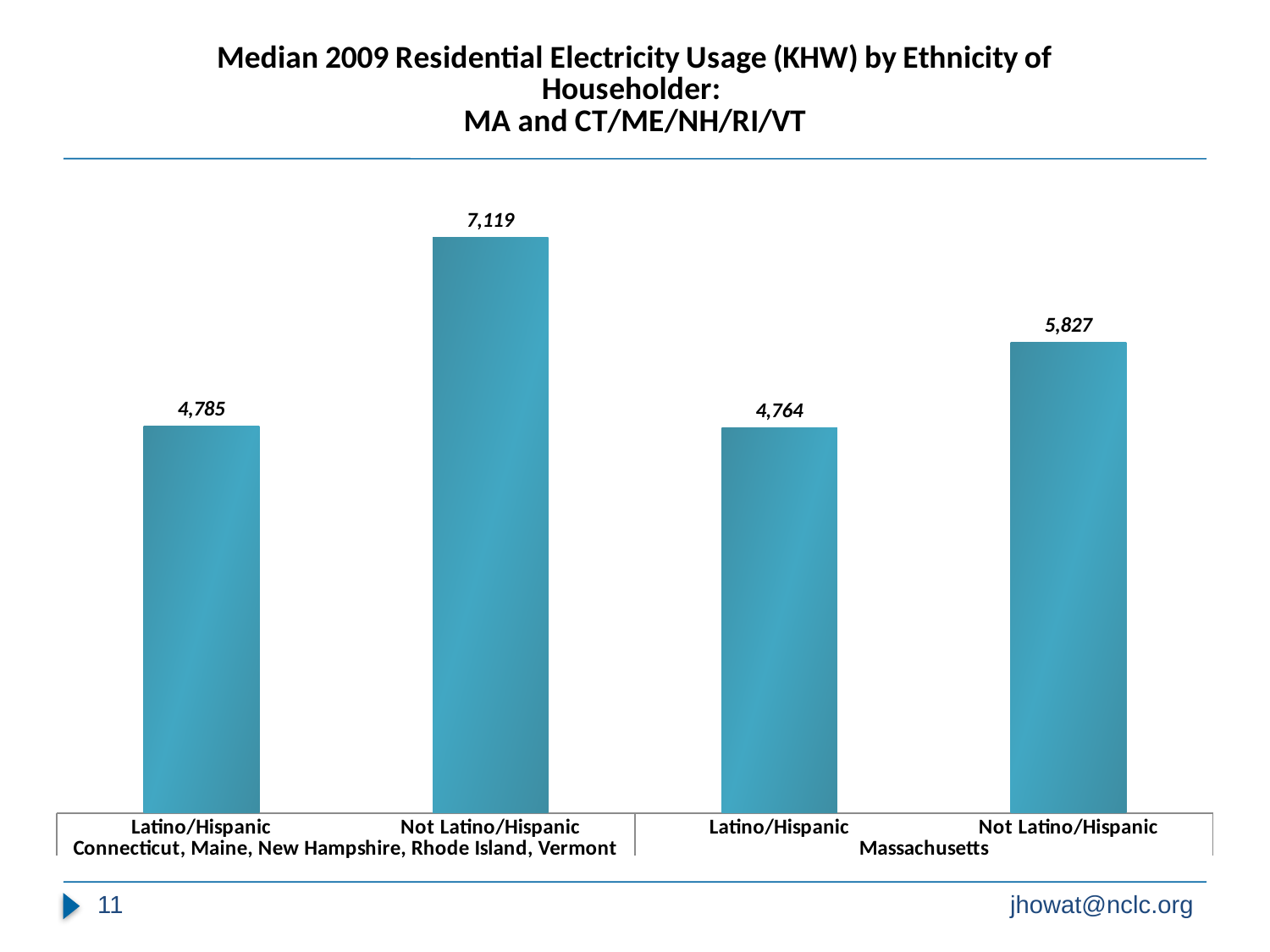
What kind of chart is shown on the slide? Bar chart What is the difference between the Not Latino/Hispanic and Latino/Hispanic values in Massachusetts? 1,063 Which bar has the highest value on the chart? Not Latino/Hispanic, Connecticut, Maine, New Hampshire, Rhode Island, Vermont What is the median 2009 residential electricity usage for Not Latino/Hispanic householders in Massachusetts? 5,827 Which bar has the lowest value on the chart? Latino/Hispanic, Massachusetts What is the difference between the Not Latino/Hispanic and Latino/Hispanic values in Connecticut, Maine, New Hampshire, Rhode Island, Vermont? 2,334 What is the median 2009 residential electricity usage for Latino/Hispanic householders in Massachusetts? 4,764 What is the median 2009 residential electricity usage for Latino/Hispanic householders in Connecticut, Maine, New Hampshire, Rhode Island, Vermont? 4,785 What is the median 2009 residential electricity usage for Not Latino/Hispanic householders in Connecticut, Maine, New Hampshire, Rhode Island, Vermont? 7,119 Which is larger: the Not Latino/Hispanic value in Massachusetts or the Not Latino/Hispanic value in Connecticut, Maine, New Hampshire, Rhode Island, Vermont? Connecticut, Maine, New Hampshire, Rhode Island, Vermont What is the title of the chart? Median 2009 Residential Electricity Usage (KHW) by Ethnicity of Householder: MA and CT/ME/NH/RI/VT How many bars are plotted on the chart? 4